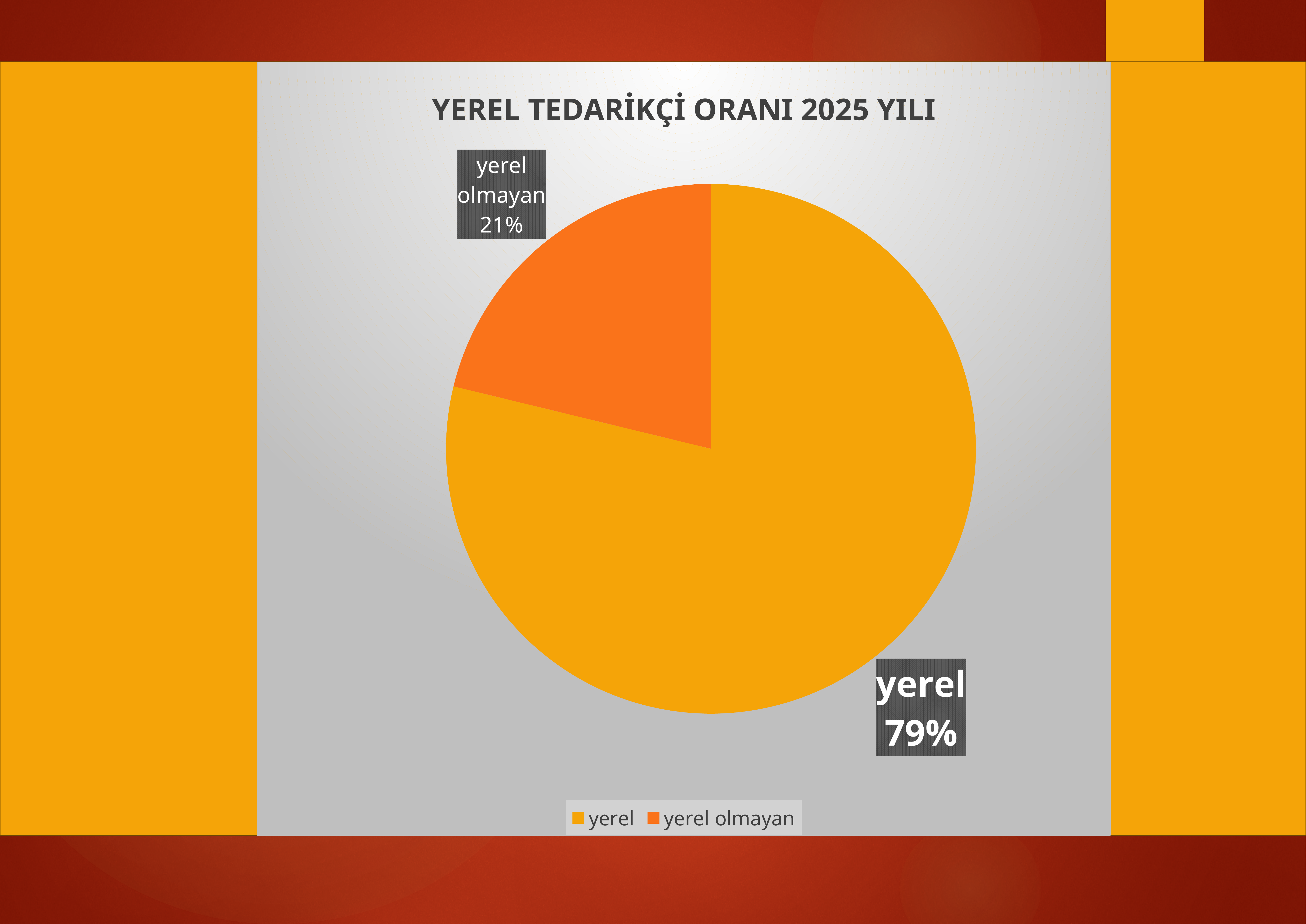
How many entries does the legend list? 2 What share of the pie does the 'yerel olmayan' slice represent? 21% What kind of chart is shown on the slide? pie chart What is the title of the chart? YEREL TEDARİKÇİ ORANI 2025 YILI What share of the pie does the 'yerel' slice represent? 79% How many slices does the pie chart have? 2 Which slice is the largest in the pie chart? yerel What is the difference in percentage points between the 'yerel' and 'yerel olmayan' slices? 58 What colour is the 'yerel olmayan' slice in the pie chart? orange Which is larger, the 'yerel' slice or the 'yerel olmayan' slice? yerel Which slice is the smallest in the pie chart? yerel olmayan